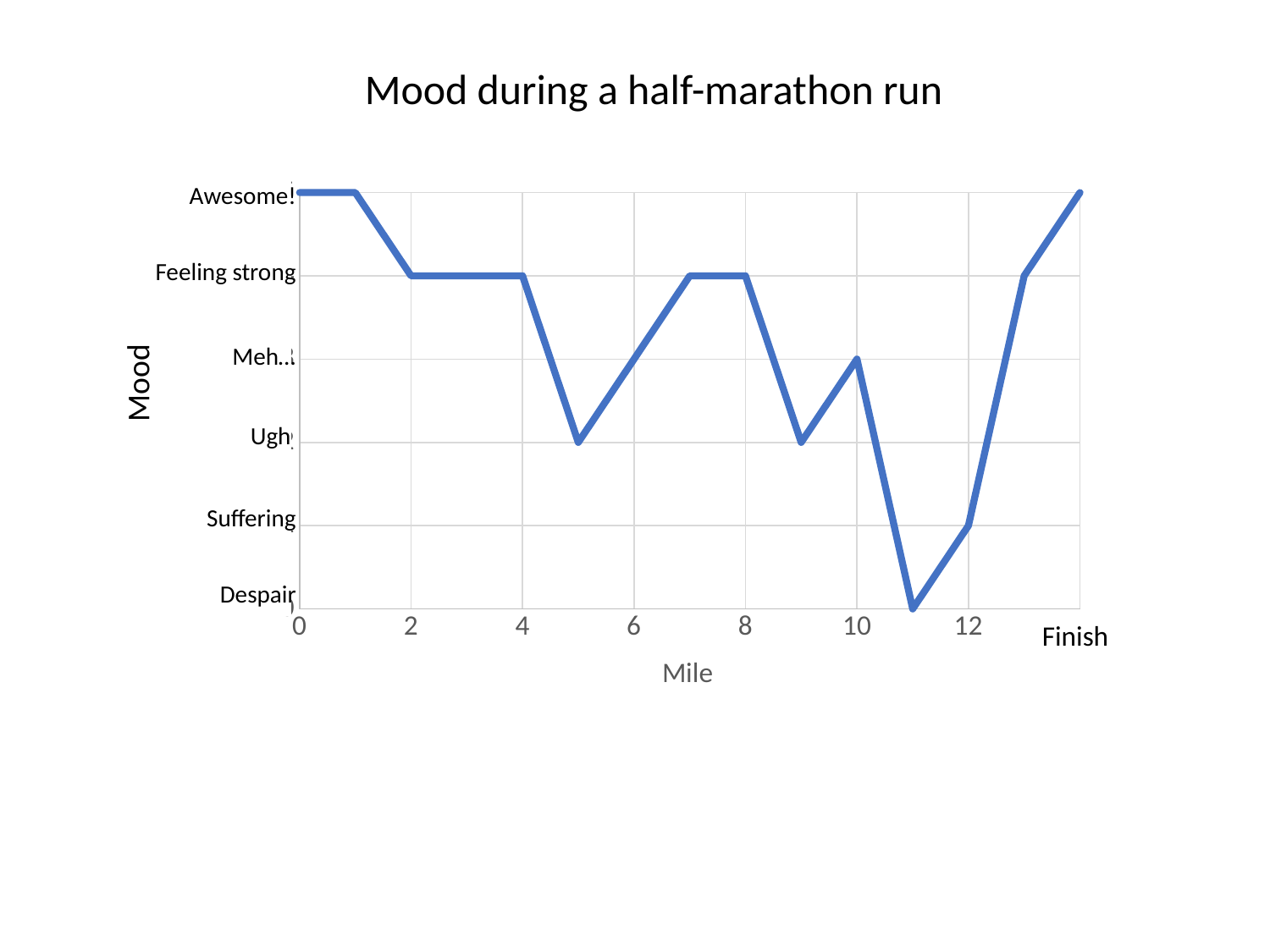
What is the mood at mile 10? Meh.. What is the mood at mile 12? Suffering What is the title of the chart? Mood during a half-marathon run What is the mood at mile 5? Ugh Does the mood rise or fall between mile 11 and the Finish? rise How many mood levels are labelled on the vertical axis? 6 What kind of chart is shown on the slide? line chart What is the mood at mile 0? Awesome! What is the mood at the Finish? Awesome! At which mile does the mood reach its lowest point? 11 What is the mood at mile 11? Despair Does the mood rise or fall between mile 8 and mile 11? fall